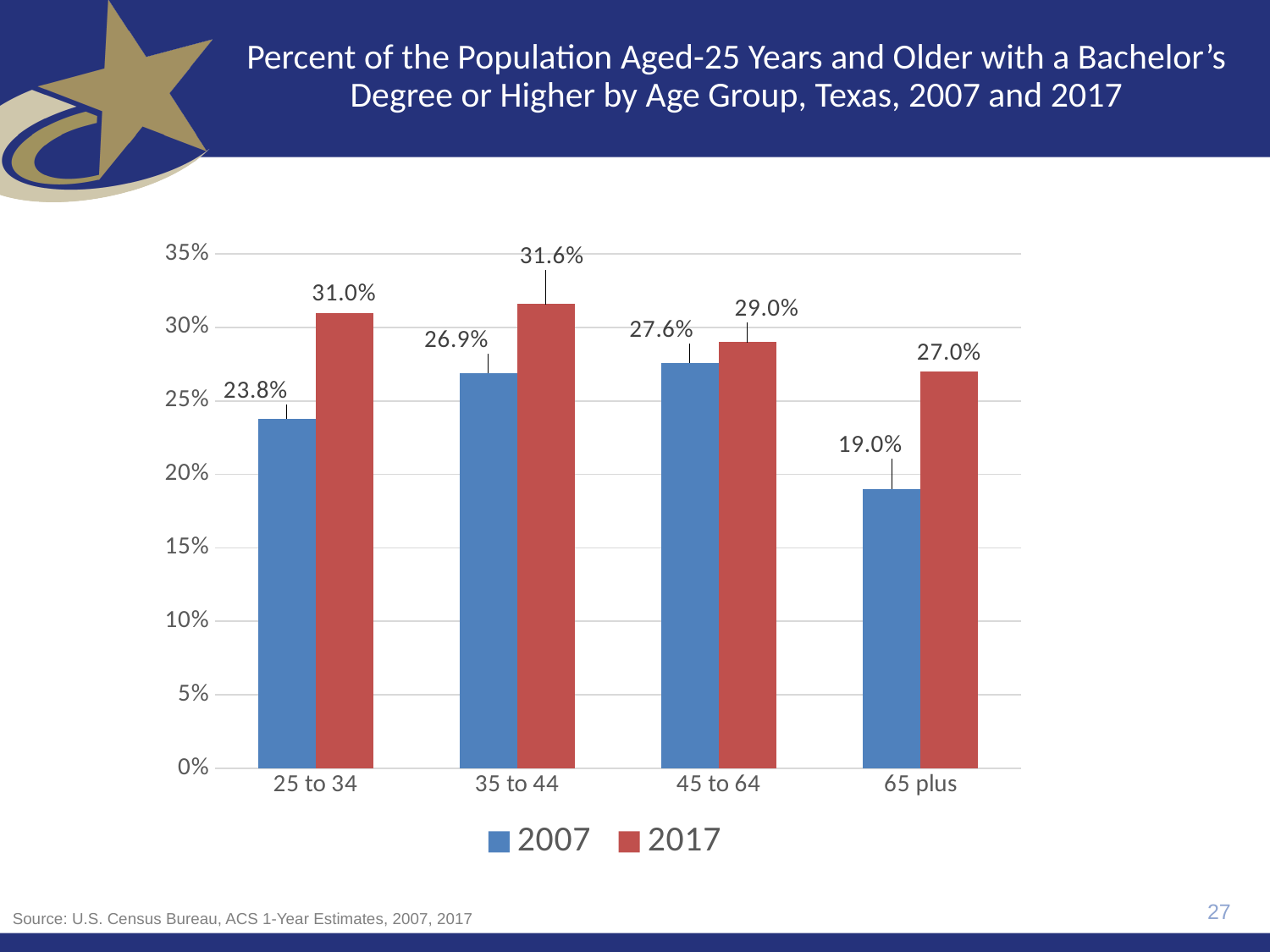
Which is larger, the 2007 value for 45 to 64 or the 2007 value for 35 to 44? 45 to 64 How many series does the legend list? 2 What is the difference between the 2017 and 2007 values for the 25 to 34 age group? 7.2% What is the difference between the 2017 and 2007 values for the 65 plus age group? 8.0% Which age group has the highest 2017 value? 35 to 44 How many age groups are shown on the x axis? 4 What is the 2007 value for the 45 to 64 age group? 27.6% What is the 2017 value for the 35 to 44 age group? 31.6% What is the 2007 value for the 65 plus age group? 19.0% What kind of chart is shown on the slide? bar chart Is the 2017 value for the 25 to 34 age group greater or less than 30%? greater Which age group has the lowest 2007 value? 65 plus